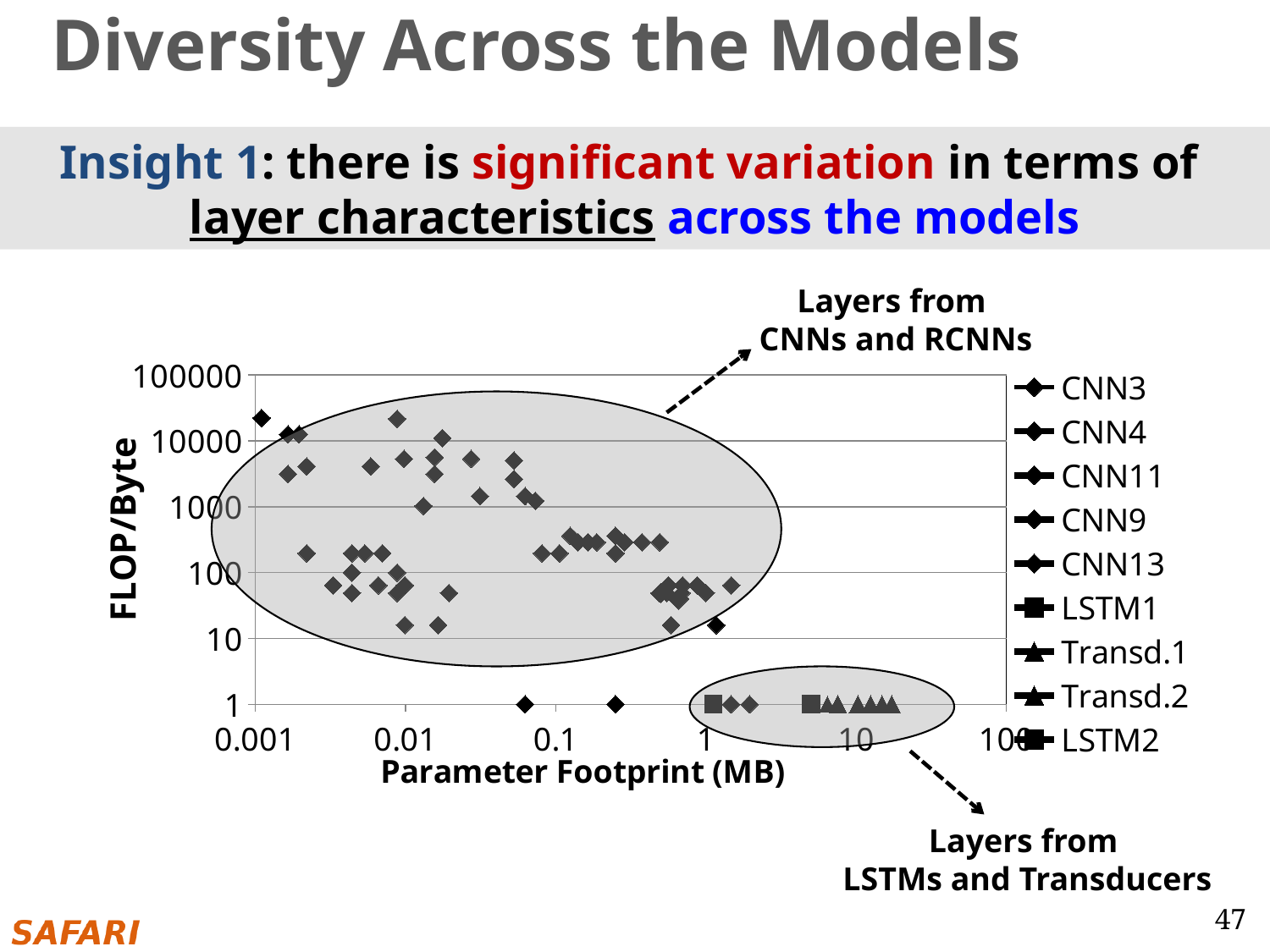
Which group of layers has higher FLOP/Byte values: the layers from CNNs and RCNNs or the layers from LSTMs and Transducers? Layers from CNNs and RCNNs What kind of chart is shown on the slide? Scatter plot According to the annotation, which models do the layers in the lower-right ellipse come from? LSTMs and Transducers What is the label of the x-axis of the chart? Parameter Footprint (MB) What is the label of the y-axis of the chart? FLOP/Byte Are the FLOP/Byte values of the layers from LSTMs and Transducers greater or less than 10? less Is the parameter footprint of the layers from LSTMs and Transducers greater or less than 0.1 MB? greater How many CNN series are listed in the legend? 5 According to the annotation, which models do the layers in the large upper ellipse come from? CNNs and RCNNs What is the highest value shown on the y-axis of the chart? 100000 How many series does the legend of the chart list? 9 What is the lowest value shown on the x-axis of the chart? 0.001